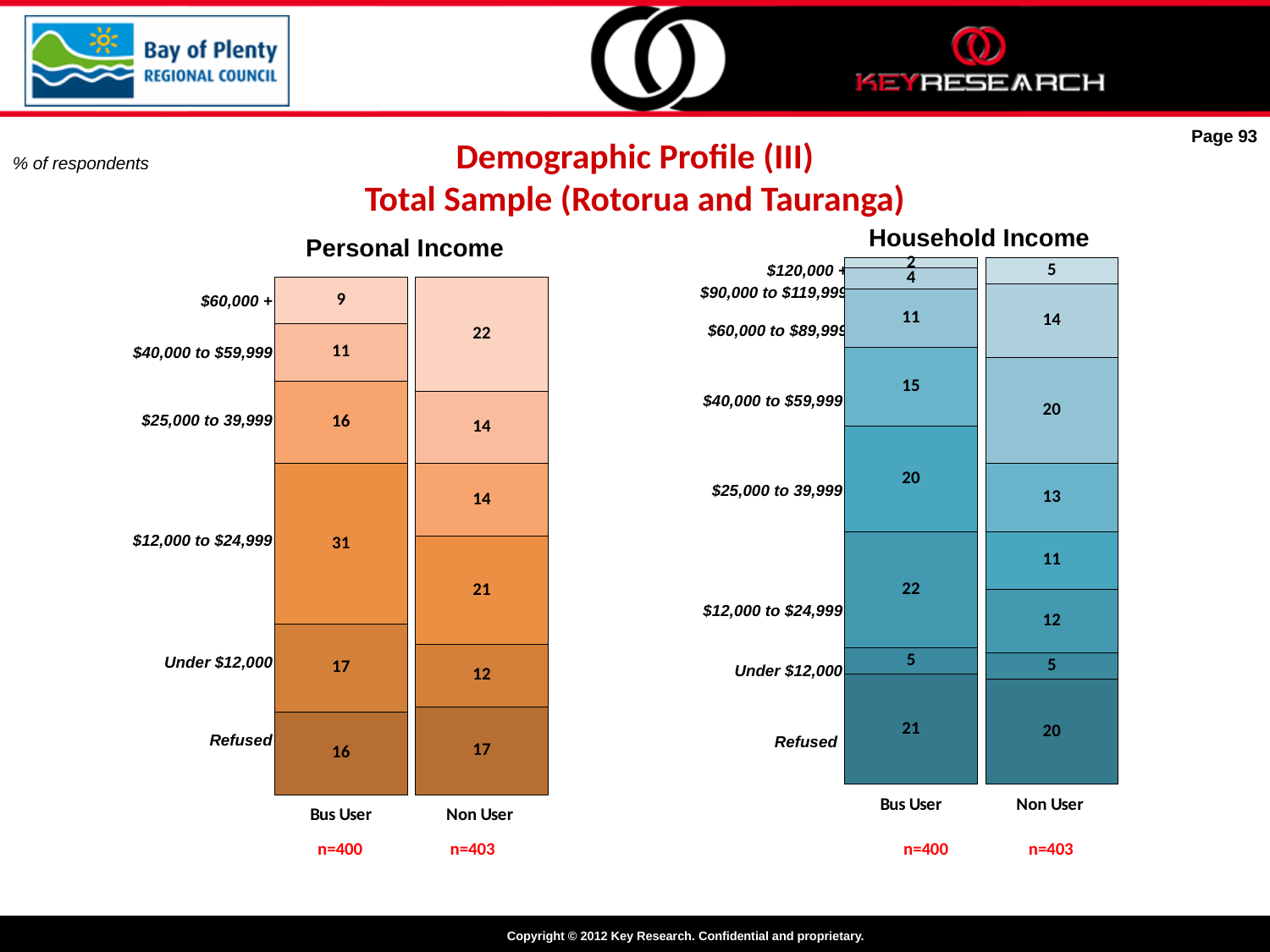
In the Household Income chart, what percentage of Non Users refused to give their income? 20 In the Personal Income chart, what percentage of Non Users are in the $60,000 + category? 22 In the Household Income chart, what percentage of Bus Users are in the $120,000 + category? 2 In the Personal Income chart, which income category has the largest share among Bus Users? $12,000 to $24,999 In the Household Income chart, which group has a larger percentage in the Refused category, Bus User or Non User? Bus User How many bars does the Household Income chart have? 2 In the Personal Income chart, which income category has the smallest share among Bus Users? $60,000 + In the Personal Income chart, what percentage of Bus Users refused to give their income? 16 In the Household Income chart, what percentage of Bus Users are in the $12,000 to $24,999 category? 22 In the Personal Income chart, what is the difference between the Bus User and Non User percentages for the $12,000 to $24,999 category? 10 What type of chart is the Personal Income chart? Stacked bar chart In the Personal Income chart, what percentage of Bus Users are in the $12,000 to $24,999 category? 31